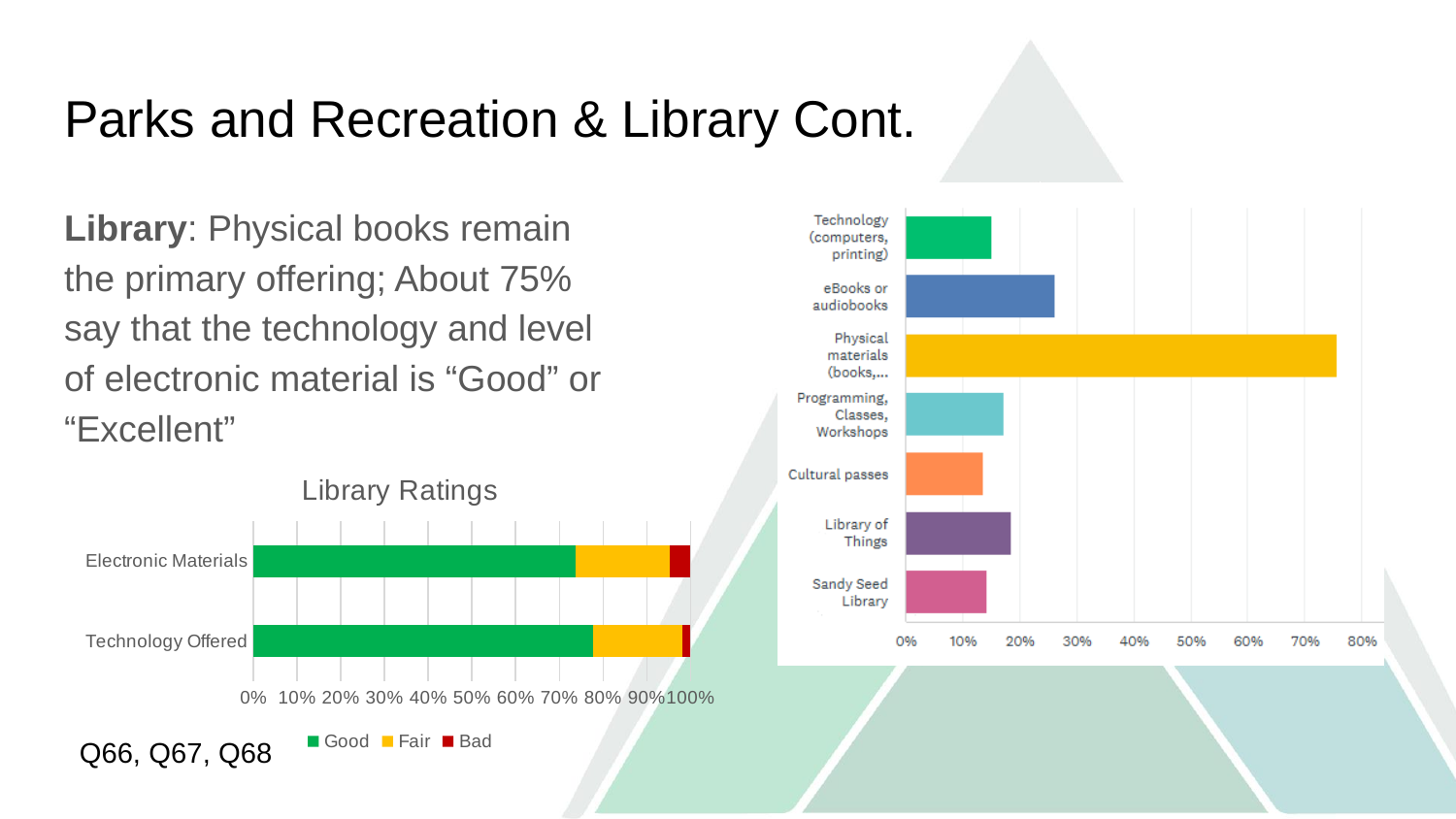
How many series does the legend of the 'Library Ratings' chart list? 3 How many categories are shown in the 'Library Ratings' chart? 2 In the 'Library Ratings' chart, is the 'Good' value for Electronic Materials greater or less than 70%? greater How many categories are shown in the chart on the right of the slide? 7 What type of chart is the 'Library Ratings' chart? stacked bar chart In the 'Library Ratings' chart, which category has the larger 'Bad' segment, Electronic Materials or Technology Offered? Electronic Materials In the chart on the right of the slide, is the value for 'eBooks or audiobooks' greater or less than 20%? greater What are the legend entries of the 'Library Ratings' chart? Good, Fair, Bad In the 'Library Ratings' chart, is the 'Bad' value for Electronic Materials greater or less than 10%? less In the chart on the right of the slide, which is larger, the value for 'eBooks or audiobooks' or the value for 'Cultural passes'? eBooks or audiobooks In the chart on the right of the slide, which category has the highest value? Physical materials (books,...